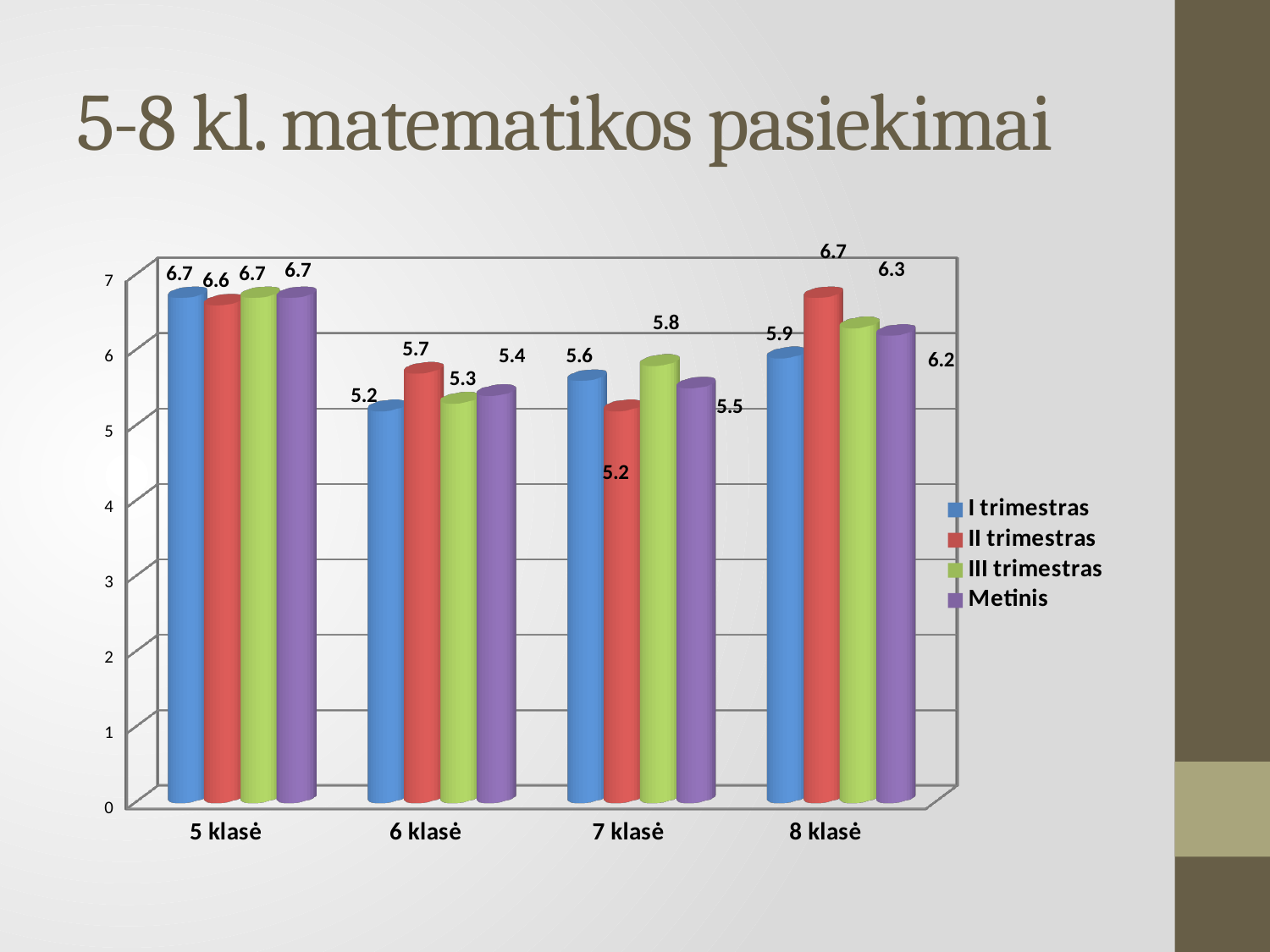
How many series does the legend list? 4 Which is larger, the II trimestras value for 6 klasė or the II trimestras value for 7 klasė? 6 klasė Which series has the highest value in 7 klasė? III trimestras What is the title of the chart? 5-8 kl. matematikos pasiekimai How many classes (categories) are shown on the x axis? 4 What kind of chart is shown on the slide? bar chart What is the Metinis value for 7 klasė? 5.5 What is the value for III trimestras in 5 klasė? 6.7 Which series has the lowest value in 8 klasė? I trimestras What is the value for I trimestras in 6 klasė? 5.2 What is the value for II trimestras in 8 klasė? 6.7 What is the difference between the II trimestras and I trimestras values in 8 klasė? 0.8